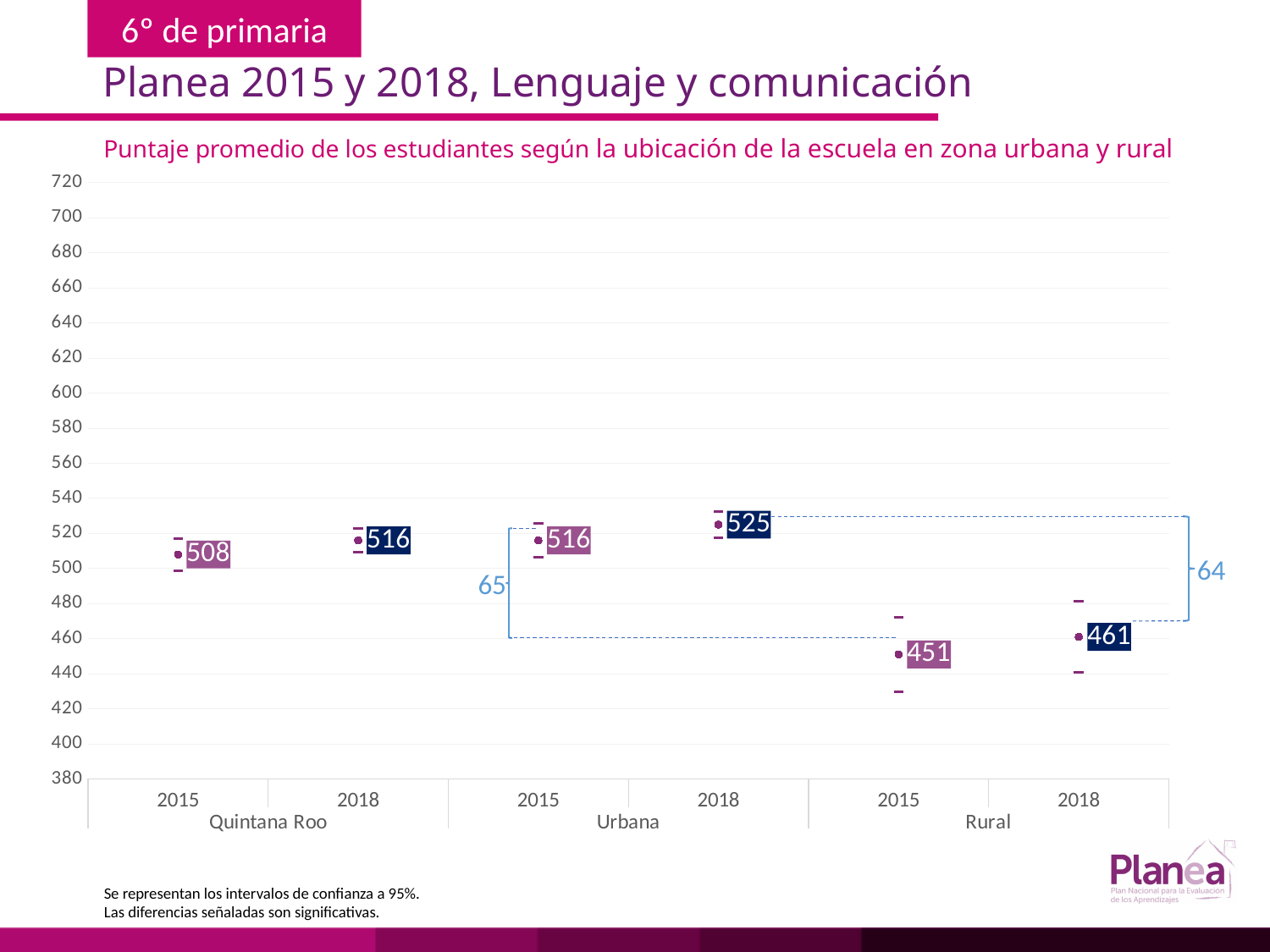
What is the average score for Rural schools in 2018? 461 Which is larger, the Quintana Roo score in 2018 or the Rural score in 2018? Quintana Roo 2018 What is the average score for Quintana Roo in 2015? 508 Which group and year has the lowest average score? Rural 2015 By how much did the Quintana Roo average score change from 2015 to 2018? 8 What is the difference between the Urbana and Rural average scores in 2018? 64 What is the difference between the Urbana and Rural average scores in 2015? 65 Did the Rural average score rise or fall from 2015 to 2018? rise What is the average score for Urbana schools in 2018? 525 Which group and year has the highest average score? Urbana 2018 What is the average score for Rural schools in 2015? 451